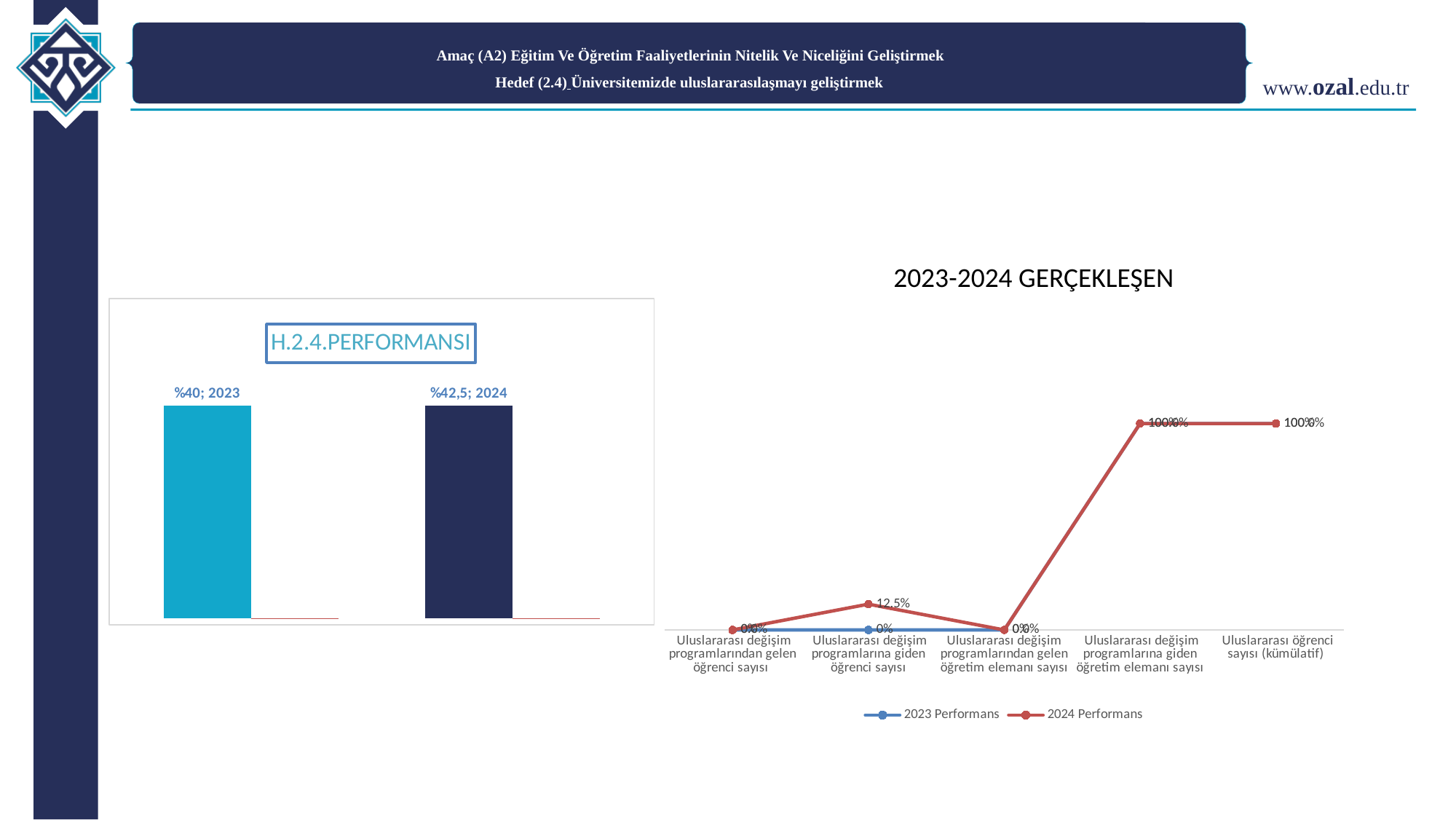
In the 2023-2024 GERÇEKLEŞEN chart, which series is drawn in red? 2024 Performans In the 2023-2024 GERÇEKLEŞEN chart, how many categories are shown on the x axis? 5 In the H.2.4.PERFORMANSI chart, how many bars are plotted? 2 What kind of chart is the 2023-2024 GERÇEKLEŞEN chart? line chart In the 2023-2024 GERÇEKLEŞEN chart, what is the 2024 Performans value for 'Uluslararası öğrenci sayısı (kümülatif)'? 100% In the H.2.4.PERFORMANSI chart, what is the value for 2023? %40 In the H.2.4.PERFORMANSI chart, what is the value for 2024? %42,5 What kind of chart is the H.2.4.PERFORMANSI chart? bar chart In the 2023-2024 GERÇEKLEŞEN chart, how many series does the legend list? 2 In the 2023-2024 GERÇEKLEŞEN chart, what is the 2023 Performans value for 'Uluslararası değişim programlarına giden öğrenci sayısı'? 0% In the 2023-2024 GERÇEKLEŞEN chart, what is the 2024 Performans value for 'Uluslararası değişim programlarına giden öğrenci sayısı'? 12,5%